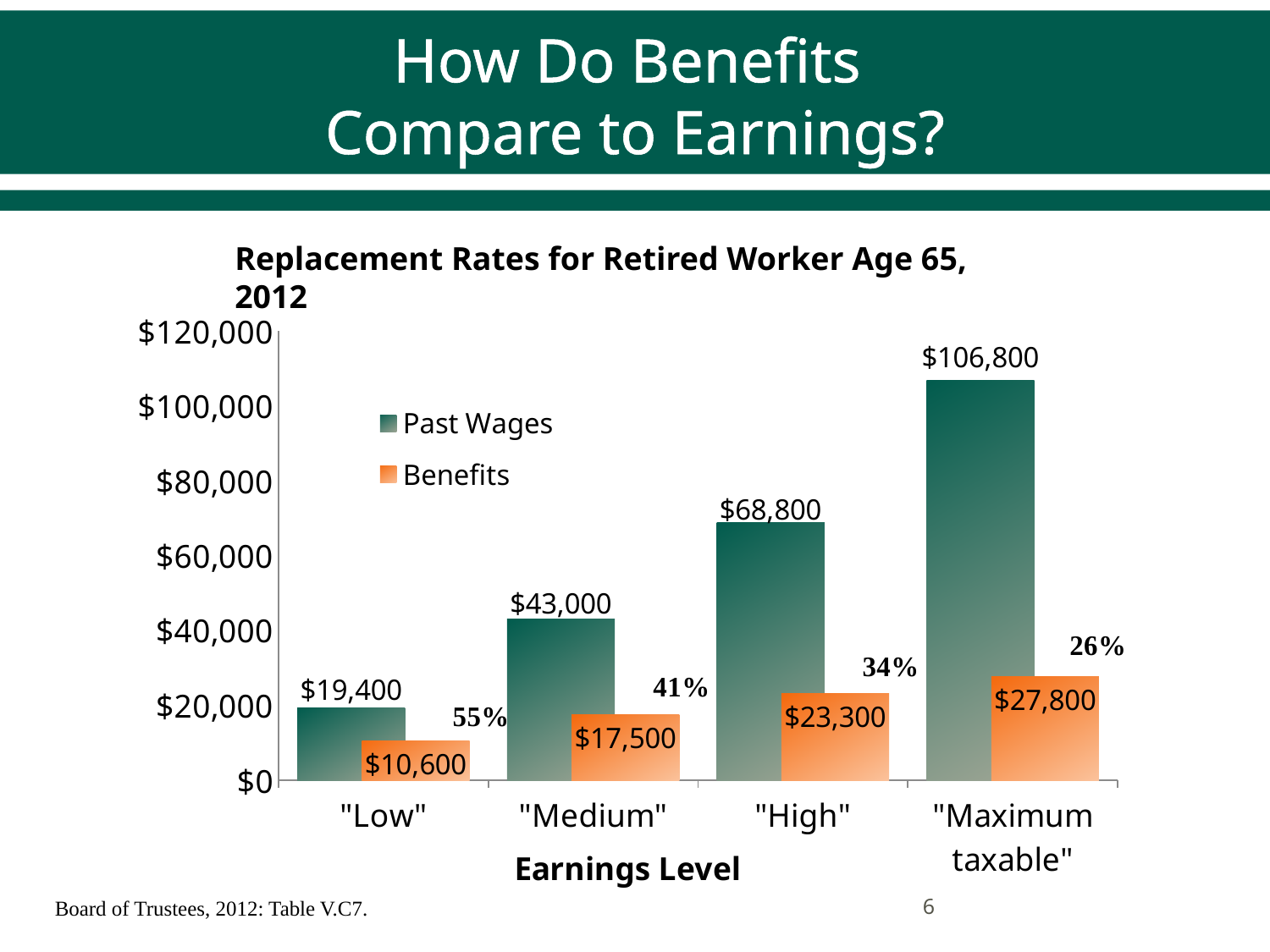
How many series does the legend list? 2 What kind of chart is shown on the slide? bar chart Which is larger: Benefits for "Medium" or Benefits for "High"? Benefits for "High" What replacement rate percentage is shown above the Benefits bar for the "Low" earnings level? 55% Which earnings level has the lowest Past Wages value? "Low" Is the Past Wages value for "High" greater or less than $60,000? greater What is the difference between Past Wages and Benefits for the "Medium" earnings level? $25,500 Which earnings level has the highest Benefits value? "Maximum taxable" What is the Past Wages value for the "Maximum taxable" earnings level? $106,800 How many earnings levels are shown on the x axis? 4 What is the Past Wages value for the "Low" earnings level? $19,400 What is the Benefits value for the "High" earnings level? $23,300